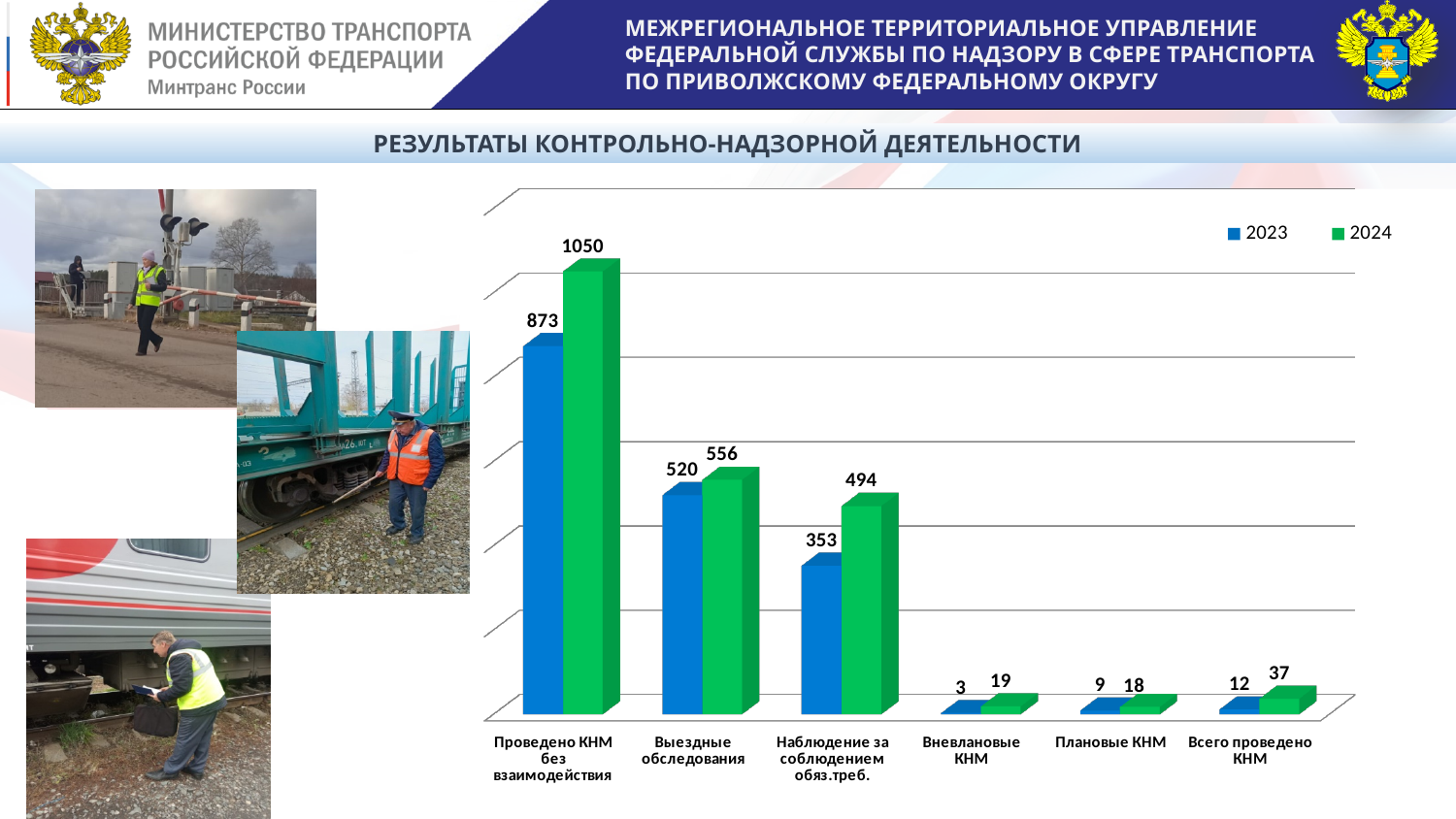
Which category has the highest 2024 value? Проведено КНМ без взаимодействия What is the 2023 value for "Наблюдение за соблюдением обяз.треб."? 353 What is the 2024 value for "Проведено КНМ без взаимодействия"? 1050 What is the 2024 value for "Всего проведено КНМ"? 37 How many series does the chart legend list? 2 What kind of chart is shown on the slide? Bar chart How many categories are shown on the x axis of the chart? 6 Which category has the lowest 2023 value? Вневлановые КНМ What is the 2023 value for "Выездные обследования"? 520 What is the difference between the 2024 and 2023 values for "Проведено КНМ без взаимодействия"? 177 What is the difference between the 2024 and 2023 values for "Наблюдение за соблюдением обяз.треб."? 141 Which is larger for "Плановые КНМ": the 2023 value or the 2024 value? 2024